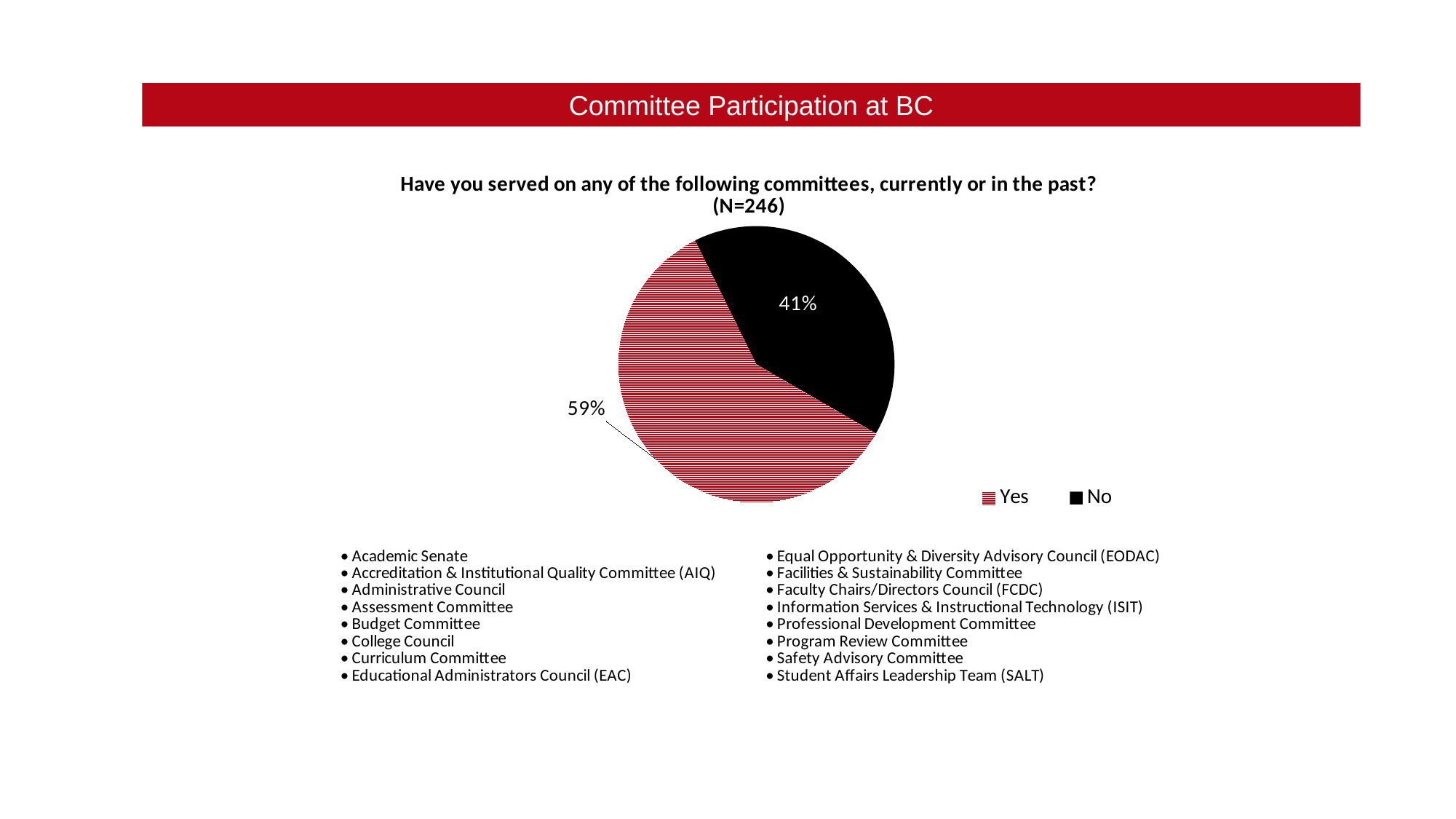
Which response has the smaller share of the pie? No What type of chart is shown on the slide? pie chart How many slices does the pie chart have? 2 Which legend entry is shown in solid black? No Is the share for Yes larger or smaller than the share for No? larger Which response has the larger share of the pie? Yes What is the sample size (N) shown in the chart title? 246 What percentage of respondents answered Yes? 59% What percentage of respondents answered No? 41% How many entries does the legend list? 2 What is the difference in percentage points between the Yes and No shares? 18